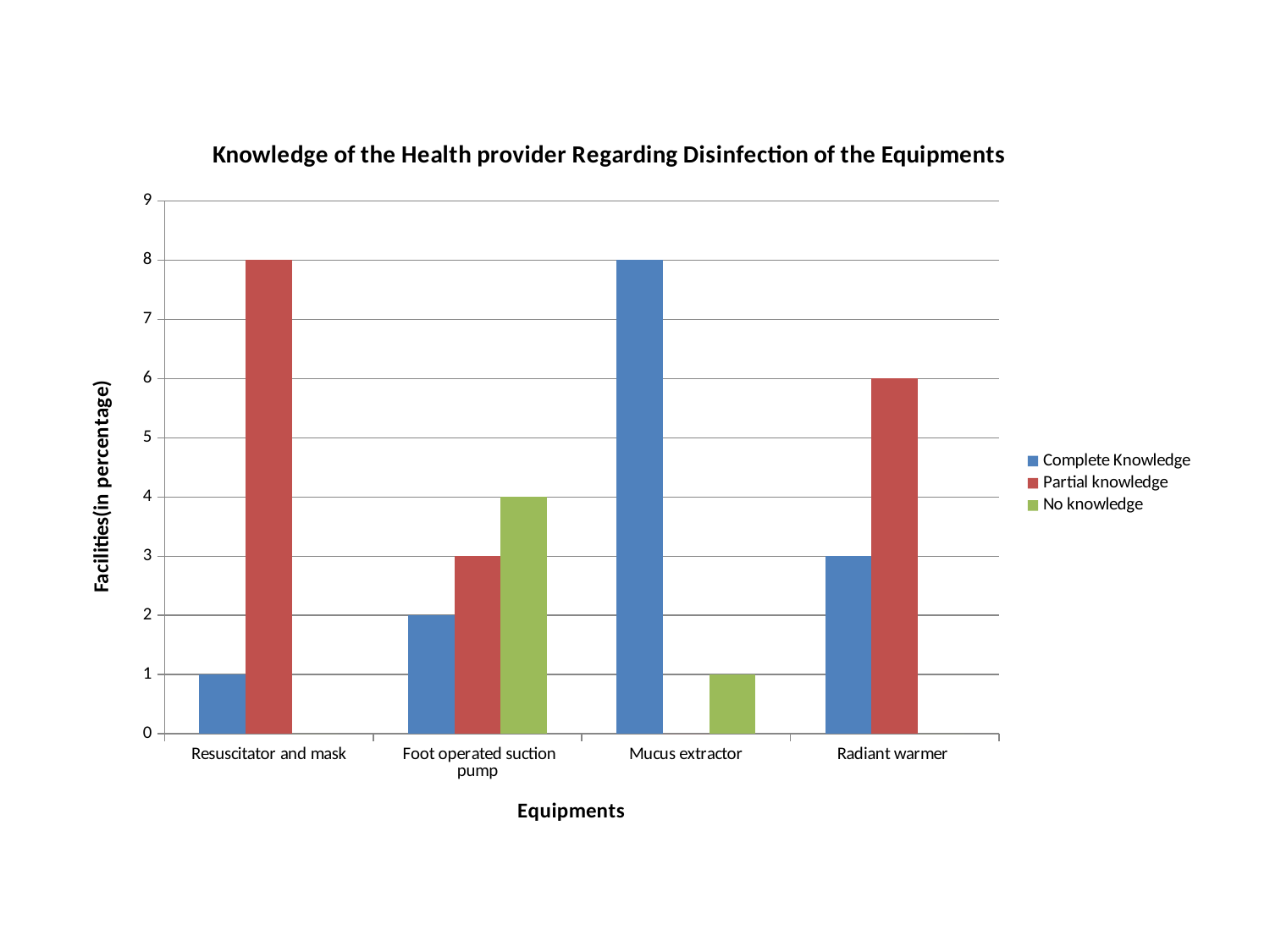
What is the difference between the Partial knowledge value for Resuscitator and mask and the Partial knowledge value for Radiant warmer? 2 Which equipment has the highest Complete Knowledge value? Mucus extractor What is the Partial knowledge value for Resuscitator and mask? 8 How many equipment categories are shown on the x axis? 4 What is the Partial knowledge value for Radiant warmer? 6 What is the title of the chart? Knowledge of the Health provider Regarding Disinfection of the Equipments How many series does the legend list? 3 Which equipment has the lowest Complete Knowledge value? Resuscitator and mask What is the No knowledge value for Foot operated suction pump? 4 What is the Complete Knowledge value for Mucus extractor? 8 What type of chart is shown on the slide? bar chart Is the Complete Knowledge value for Radiant warmer larger or smaller than the Partial knowledge value for Radiant warmer? smaller